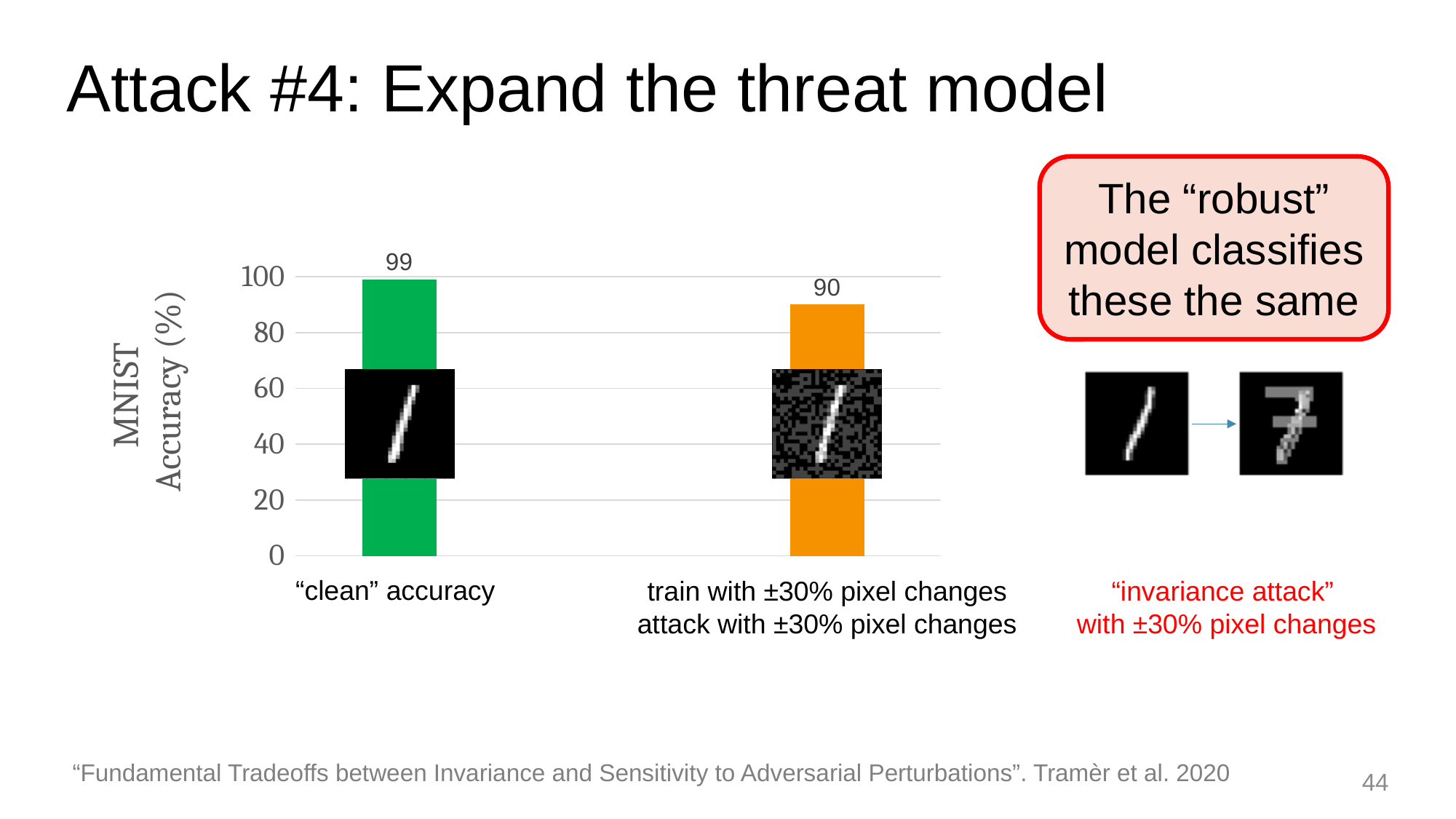
What is the MNIST accuracy (%) for "clean" accuracy? 99 What kind of chart is shown on the slide? bar chart Is the accuracy for "train with ±30% pixel changes, attack with ±30% pixel changes" greater or less than 80? greater Which is larger: the "clean" accuracy or the accuracy when training and attacking with ±30% pixel changes? "clean" accuracy What is the MNIST accuracy (%) for "train with ±30% pixel changes, attack with ±30% pixel changes"? 90 Which bar has the highest MNIST accuracy? "clean" accuracy What is the maximum value shown on the y axis of the chart? 100 What is the difference in MNIST accuracy between "clean" accuracy and "train with ±30% pixel changes, attack with ±30% pixel changes"? 9 What is the label of the y axis of the chart? MNIST Accuracy (%) How many bars are plotted in the chart? 2 What colour is the bar for "clean" accuracy? green